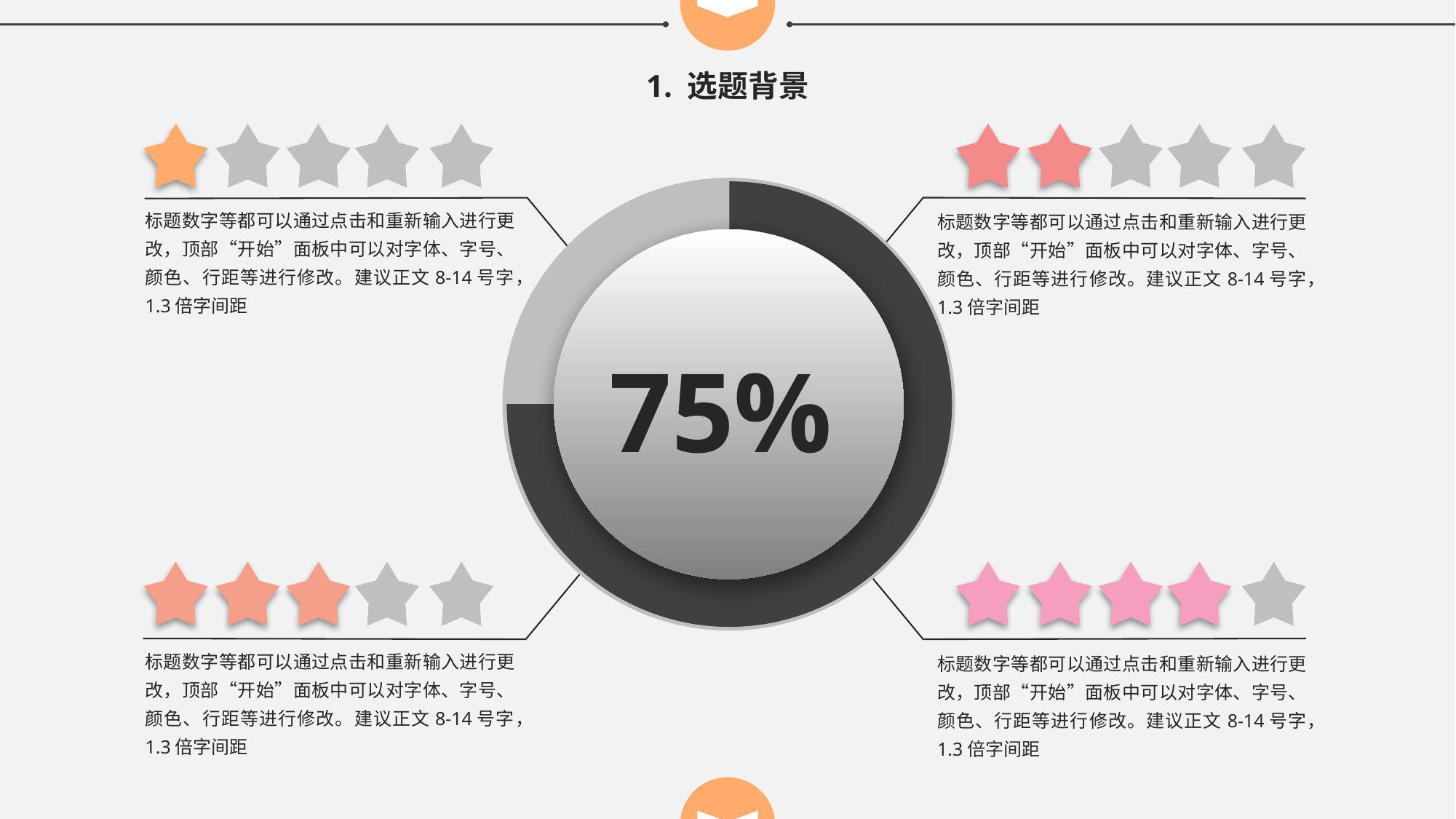
What share of the doughnut chart does the dark grey segment represent? 75% What share of the doughnut chart does the light grey segment represent? 25% What colour is the segment of the doughnut chart that represents 75%? dark grey What percentage is printed in the centre of the doughnut chart? 75% Which segment of the doughnut chart is larger, the dark grey one or the light grey one? dark grey Is the value shown in the doughnut chart greater or less than 50%? greater What is the title of the slide containing the doughnut chart? 1. 选题背景 What kind of chart is shown in the centre of the slide? doughnut chart How many segments does the doughnut chart have? 2